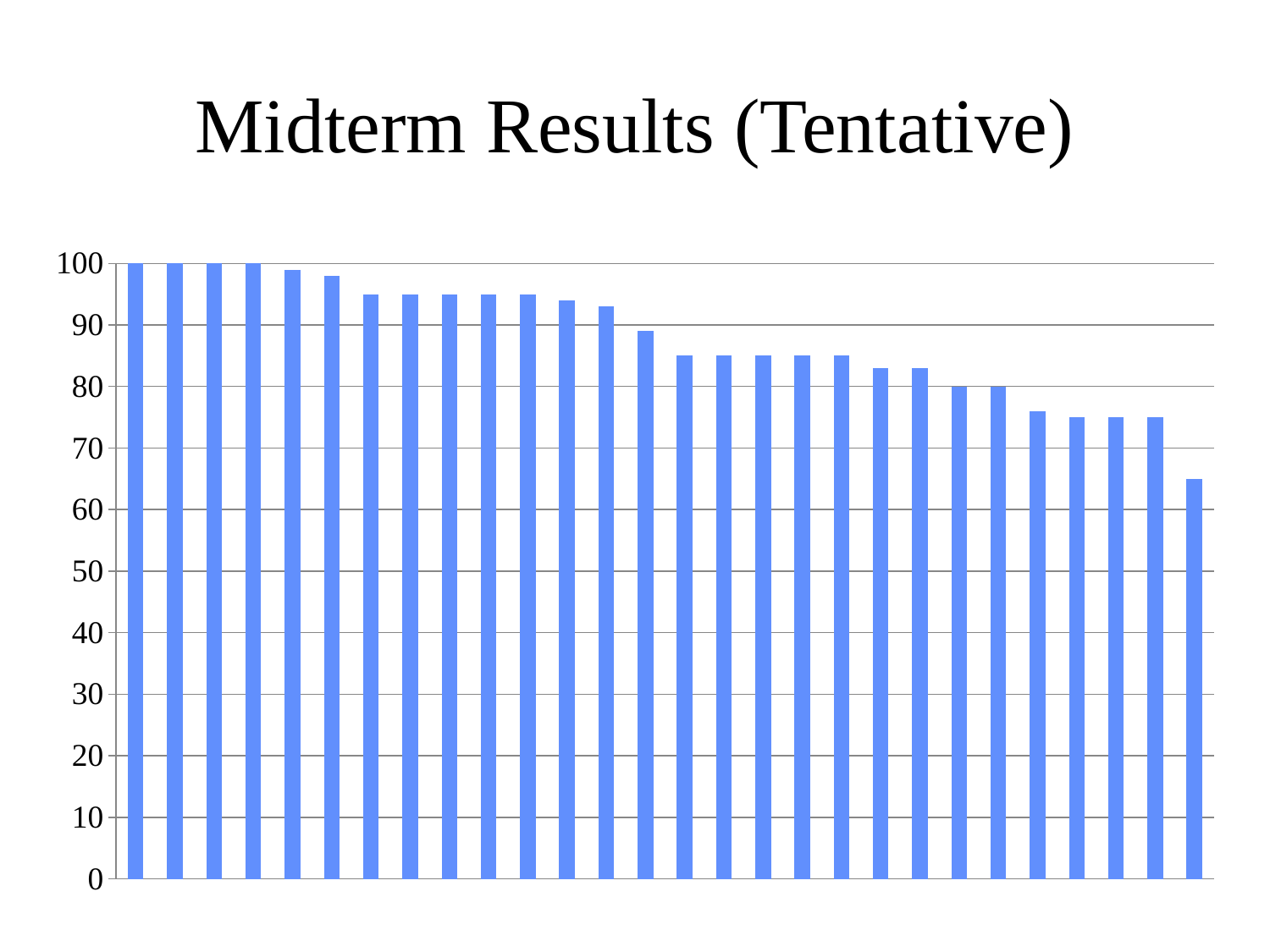
What is the highest value reached by any bar in the chart? 100 What kind of chart is shown on the slide? bar chart Which is larger, the leftmost bar or the rightmost bar? the leftmost bar What is the title of the chart? Midterm Results (Tentative) Is the value of the rightmost bar greater or less than 60? greater How many bars fall below 70? 1 What is the maximum value shown on the vertical axis? 100 How many bars are plotted in the chart? 28 What is the value of the leftmost bar? 100 How many bars reach the value 100? 4 Is the value of the rightmost bar greater or less than 70? less Do the bar values rise or fall from left to right across the chart? fall